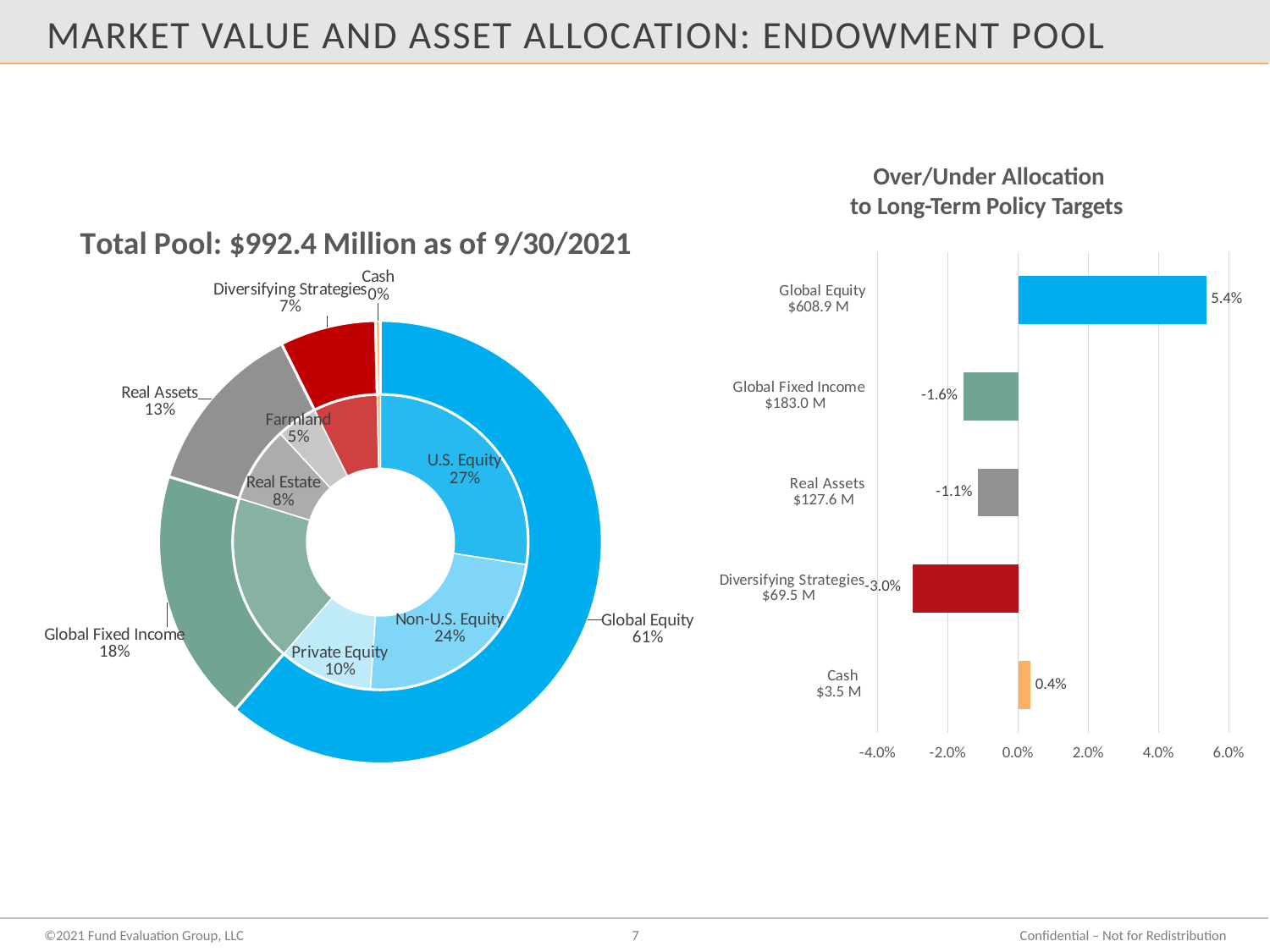
In the Total Pool donut chart, what is the difference between the Global Equity share and the Global Fixed Income share? 43% In the Over/Under Allocation to Long-Term Policy Targets chart, what is the value for Global Fixed Income? -1.6% What is the title of the donut chart on the left of the slide? Total Pool: $992.4 Million as of 9/30/2021 In the Total Pool donut chart, what percentage of the pool is Global Equity? 61% In the Total Pool donut chart, which asset class in the outer ring has the largest share? Global Equity In the Over/Under Allocation to Long-Term Policy Targets chart, what market value is listed for Global Equity? $608.9 M How many categories are shown in the Over/Under Allocation to Long-Term Policy Targets chart? 5 In the Total Pool donut chart, what percentage is shown for U.S. Equity in the inner ring? 27% What kind of chart is the Over/Under Allocation to Long-Term Policy Targets chart? Bar chart In the Total Pool donut chart, which is larger: Real Assets or Diversifying Strategies? Real Assets In the Over/Under Allocation to Long-Term Policy Targets chart, which category has the lowest value? Diversifying Strategies In the Over/Under Allocation to Long-Term Policy Targets chart, which category has the highest value? Global Equity